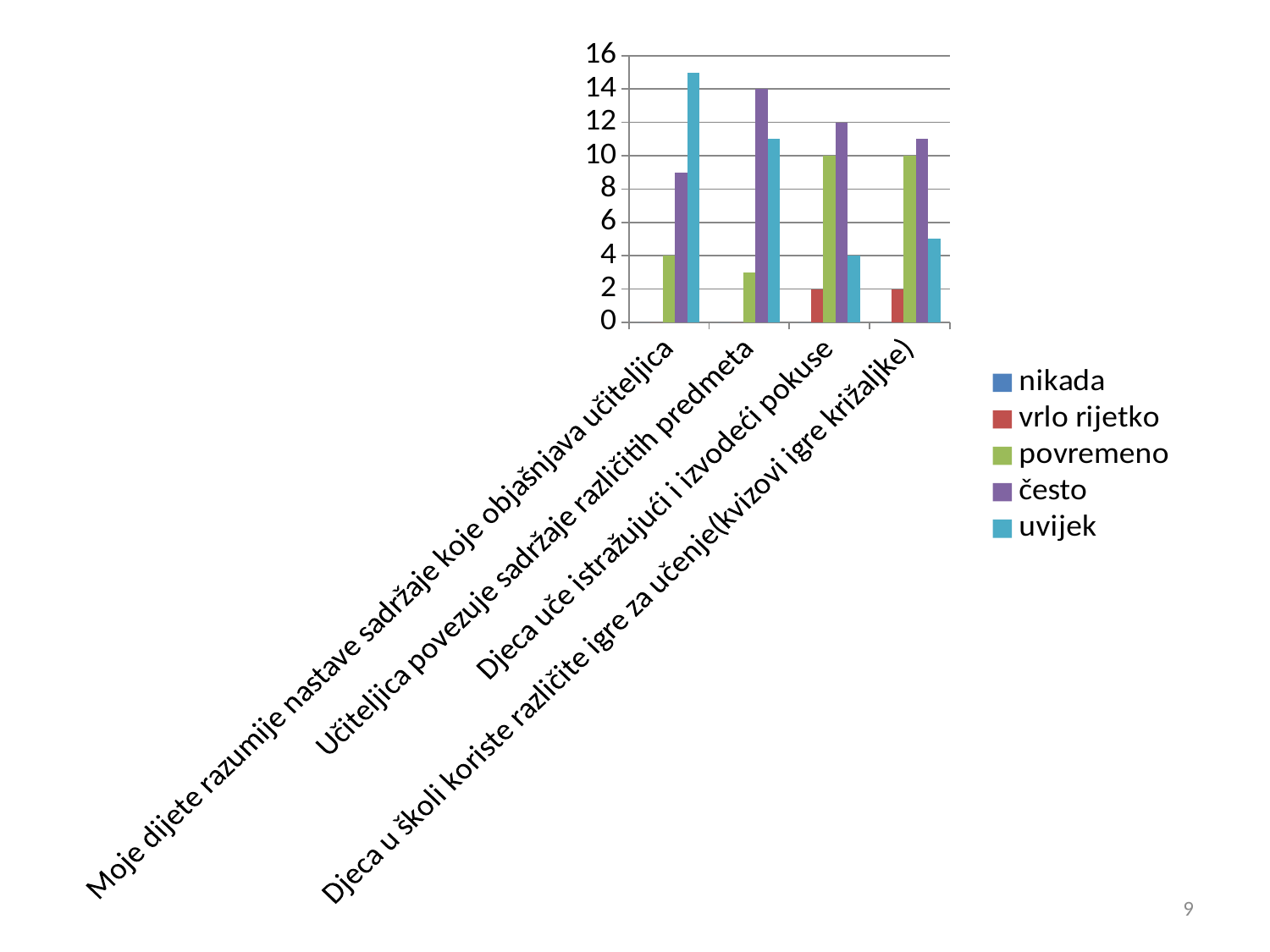
What is the value of 'povremeno' for 'Moje dijete razumije nastave sadržaje koje objašnjava učiteljica'? 4 How many series does the legend list? 5 Is the value of 'često' for 'Moje dijete razumije nastave sadržaje koje objašnjava učiteljica' greater or less than 10? less How many categories are shown on the x axis? 4 What is the value of 'vrlo rijetko' for 'Djeca u školi koriste različite igre za učenje(kvizovi igre križaljke)'? 2 What kind of chart is shown on the slide? bar chart Which series has the highest value for 'Moje dijete razumije nastave sadržaje koje objašnjava učiteljica'? uvijek What is the value of 'često' for 'Djeca uče istražujući i izvodeći pokuse'? 12 What is the difference between 'često' and 'povremeno' for 'Djeca uče istražujući i izvodeći pokuse'? 2 Which is larger: 'uvijek' for 'Moje dijete razumije nastave sadržaje koje objašnjava učiteljica' or 'uvijek' for 'Djeca u školi koriste različite igre za učenje(kvizovi igre križaljke)'? Moje dijete razumije nastave sadržaje koje objašnjava učiteljica Which series has the highest value for 'Učiteljica povezuje sadržaje različitih predmeta'? često What is the value of 'često' for 'Učiteljica povezuje sadržaje različitih predmeta'? 14